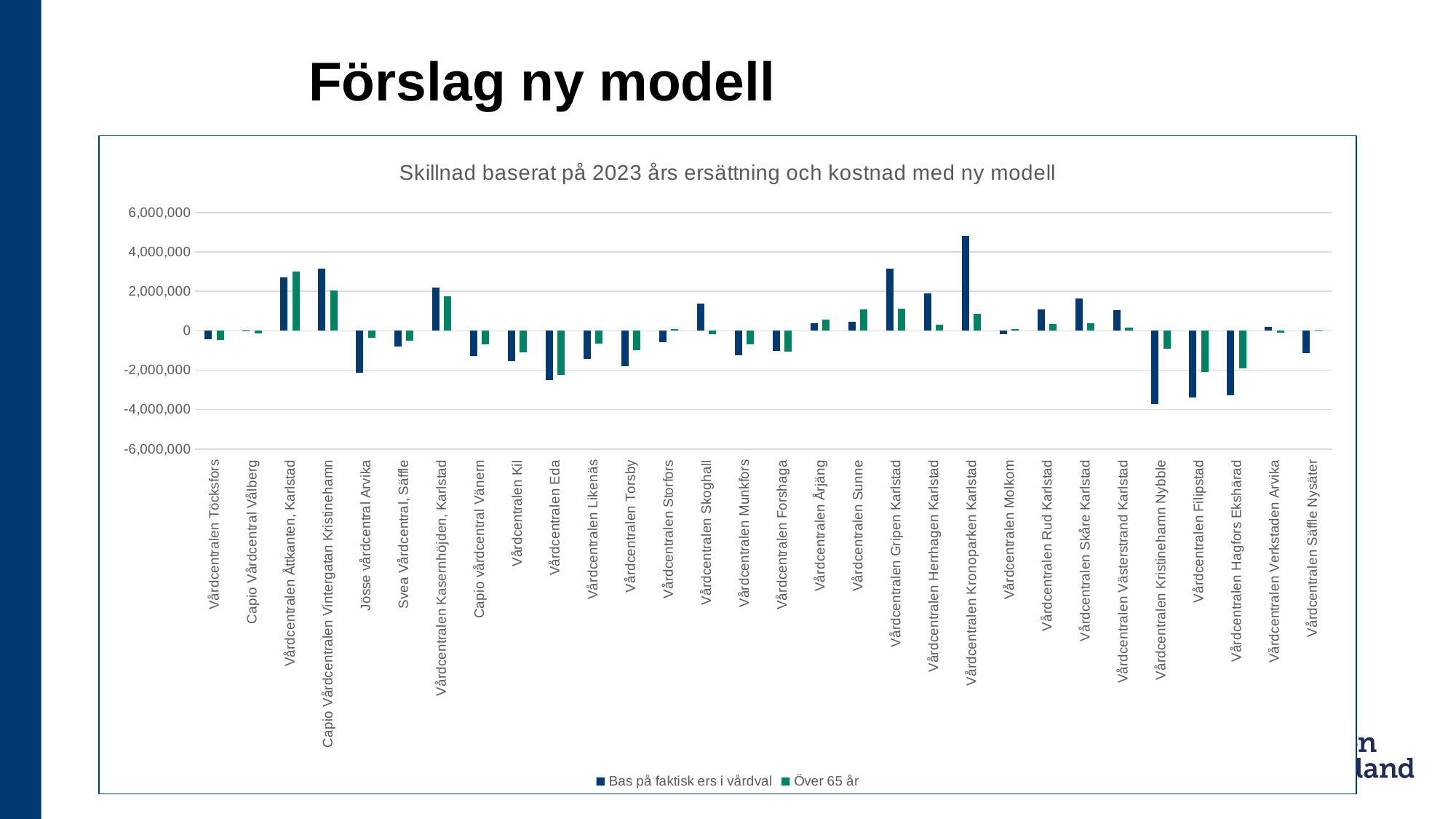
Which category has the highest value for the series 'Över 65 år'? Vårdcentralen Åttkanten, Karlstad What are the two series named in the legend? Bas på faktisk ers i vårdval; Över 65 år How many series does the legend list? 2 Which category has the highest value for the series 'Bas på faktisk ers i vårdval'? Vårdcentralen Kronoparken Karlstad How many vårdcentraler (categories) are shown on the x axis? 30 Is the 'Över 65 år' value for Vårdcentralen Åttkanten, Karlstad greater or less than 2,000,000? greater Is the 'Bas på faktisk ers i vårdval' value for Vårdcentralen Gripen Karlstad greater or less than 2,000,000? greater Is the 'Bas på faktisk ers i vårdval' value for Vårdcentralen Kristinehamn Nybble greater or less than -2,000,000? less What is the title of the chart? Skillnad baserat på 2023 års ersättning och kostnad med ny modell What kind of chart is shown on the slide? Bar chart For the series 'Bas på faktisk ers i vårdval', which is larger: Vårdcentralen Kronoparken Karlstad or Vårdcentralen Gripen Karlstad? Vårdcentralen Kronoparken Karlstad